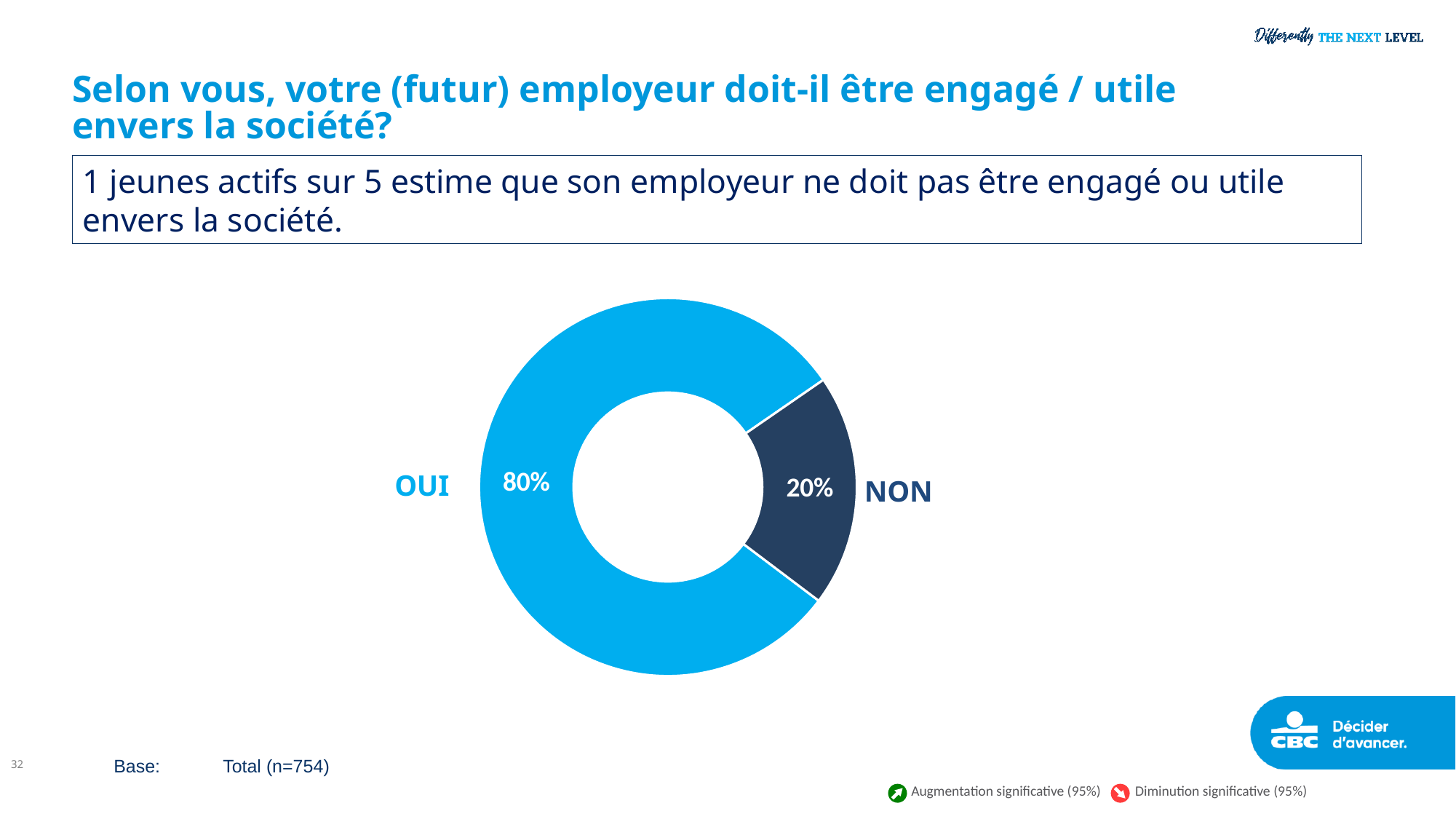
Which category has the largest share of the chart? OUI What is the difference in percentage points between OUI and NON? 60 What percentage of respondents answered OUI? 80% What share of the chart does the NON slice represent? 20% What is the base (sample size) indicated for the chart? Total (n=754) Which colour is used for the OUI slice? Light blue What kind of chart is shown on the slide? Doughnut chart How many categories are shown in the chart? 2 Which is larger, the share for OUI or the share for NON? OUI Which category has the smallest share of the chart? NON What percentage of respondents answered NON? 20%